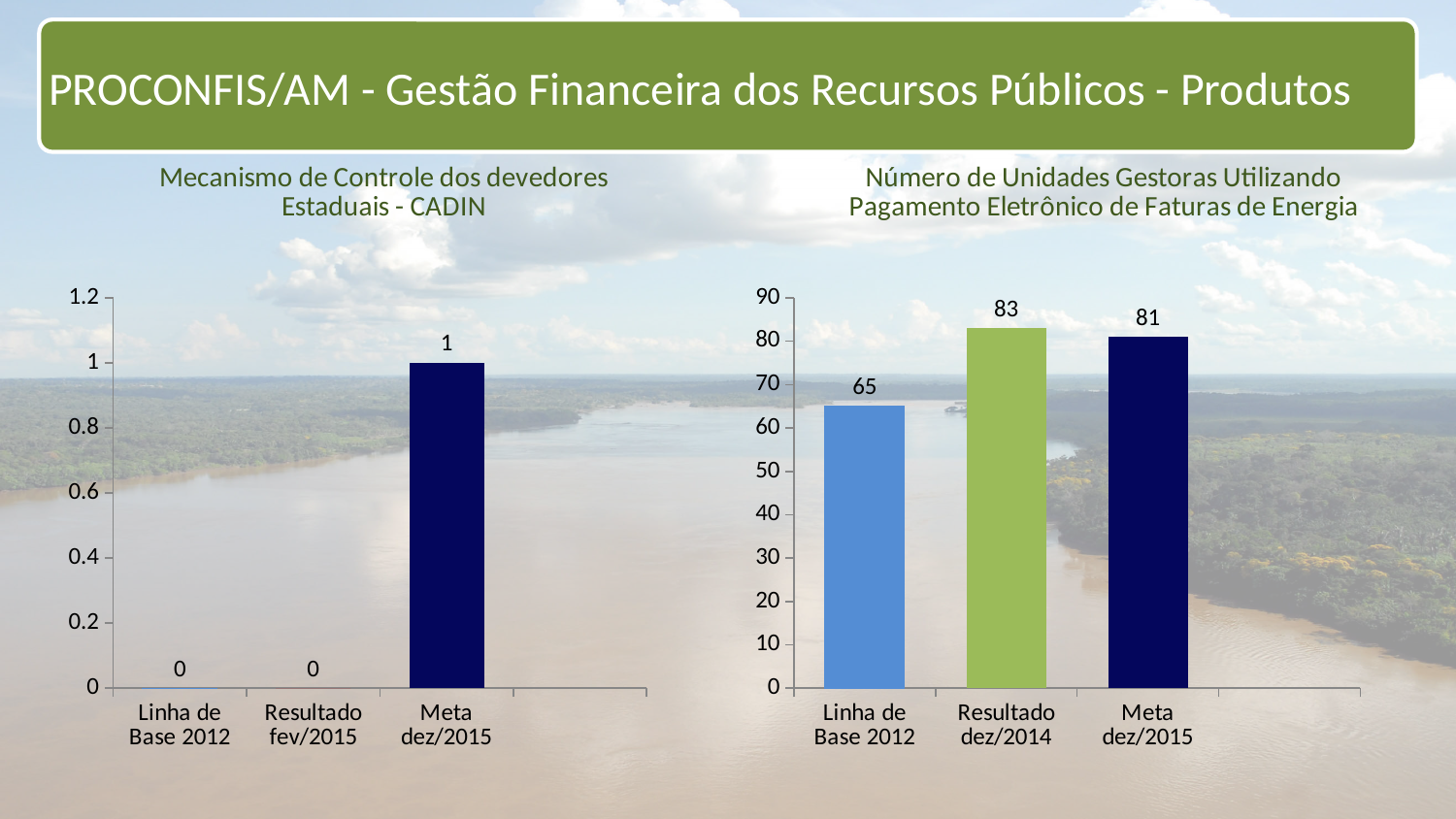
In the right chart (Número de Unidades Gestoras Utilizando Pagamento Eletrônico de Faturas de Energia), which is larger: Resultado dez/2014 or Meta dez/2015? Resultado dez/2014 In the right chart (Número de Unidades Gestoras Utilizando Pagamento Eletrônico de Faturas de Energia), which category has the lowest value? Linha de Base 2012 In the left chart (Mecanismo de Controle dos devedores Estaduais - CADIN), what is the value for Resultado fev/2015? 0 In the left chart (Mecanismo de Controle dos devedores Estaduais - CADIN), what is the value for Meta dez/2015? 1 What kind of chart is the right chart (Número de Unidades Gestoras Utilizando Pagamento Eletrônico de Faturas de Energia)? Bar chart In the right chart (Número de Unidades Gestoras Utilizando Pagamento Eletrônico de Faturas de Energia), what is the value for Resultado dez/2014? 83 In the left chart (Mecanismo de Controle dos devedores Estaduais - CADIN), how many categories are shown on the x axis? 3 In the right chart (Número de Unidades Gestoras Utilizando Pagamento Eletrônico de Faturas de Energia), what is the difference between Resultado dez/2014 and Linha de Base 2012? 18 In the right chart (Número de Unidades Gestoras Utilizando Pagamento Eletrônico de Faturas de Energia), what colour is the bar for Resultado dez/2014? Green In the left chart (Mecanismo de Controle dos devedores Estaduais - CADIN), which category has the highest value? Meta dez/2015 In the right chart (Número de Unidades Gestoras Utilizando Pagamento Eletrônico de Faturas de Energia), what is the value for Meta dez/2015? 81 In the right chart (Número de Unidades Gestoras Utilizando Pagamento Eletrônico de Faturas de Energia), what is the value for Linha de Base 2012? 65